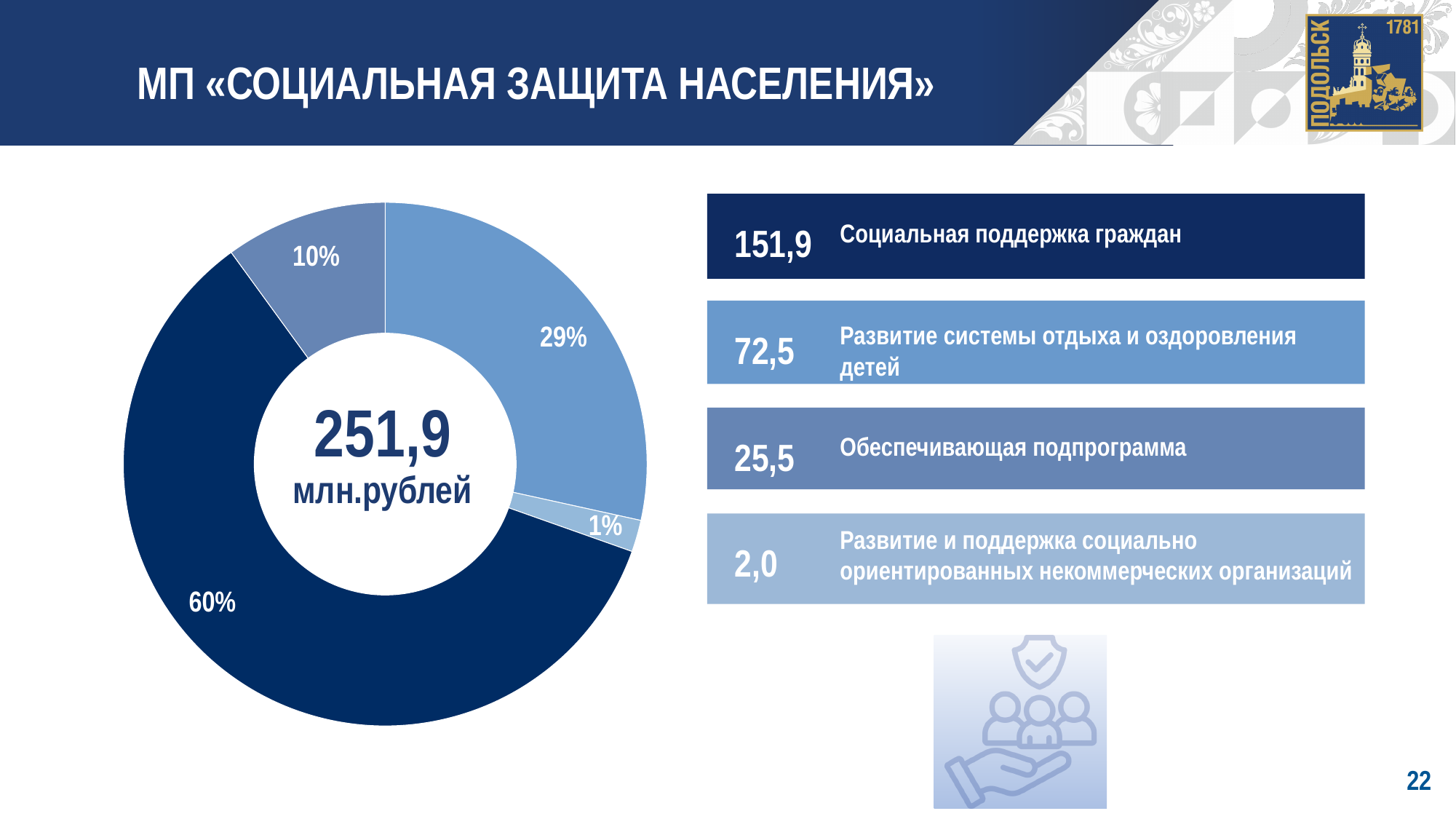
What kind of chart is shown on the slide? Pie chart (donut) What is the value shown for «Развитие системы отдыха и оздоровления детей»? 72,5 What is the value shown for «Обеспечивающая подпрограмма»? 25,5 Which subprogramme has the highest value in the list next to the chart? Социальная поддержка граждан How many slices does the donut chart have? 4 What share of the donut chart does the smallest slice take? 1% What is the title of the slide containing the donut chart? МП «СОЦИАЛЬНАЯ ЗАЩИТА НАСЕЛЕНИЯ» Which subprogramme has the lowest value in the list next to the chart? Развитие и поддержка социально ориентированных некоммерческих организаций What is the difference between the values for «Социальная поддержка граждан» and «Развитие системы отдыха и оздоровления детей»? 79,4 What total value is shown in the centre of the donut chart? 251,9 млн.рублей Which is larger: the value for «Обеспечивающая подпрограмма» or for «Развитие и поддержка социально ориентированных некоммерческих организаций»? Обеспечивающая подпрограмма What share of the donut chart does the largest slice take? 60%